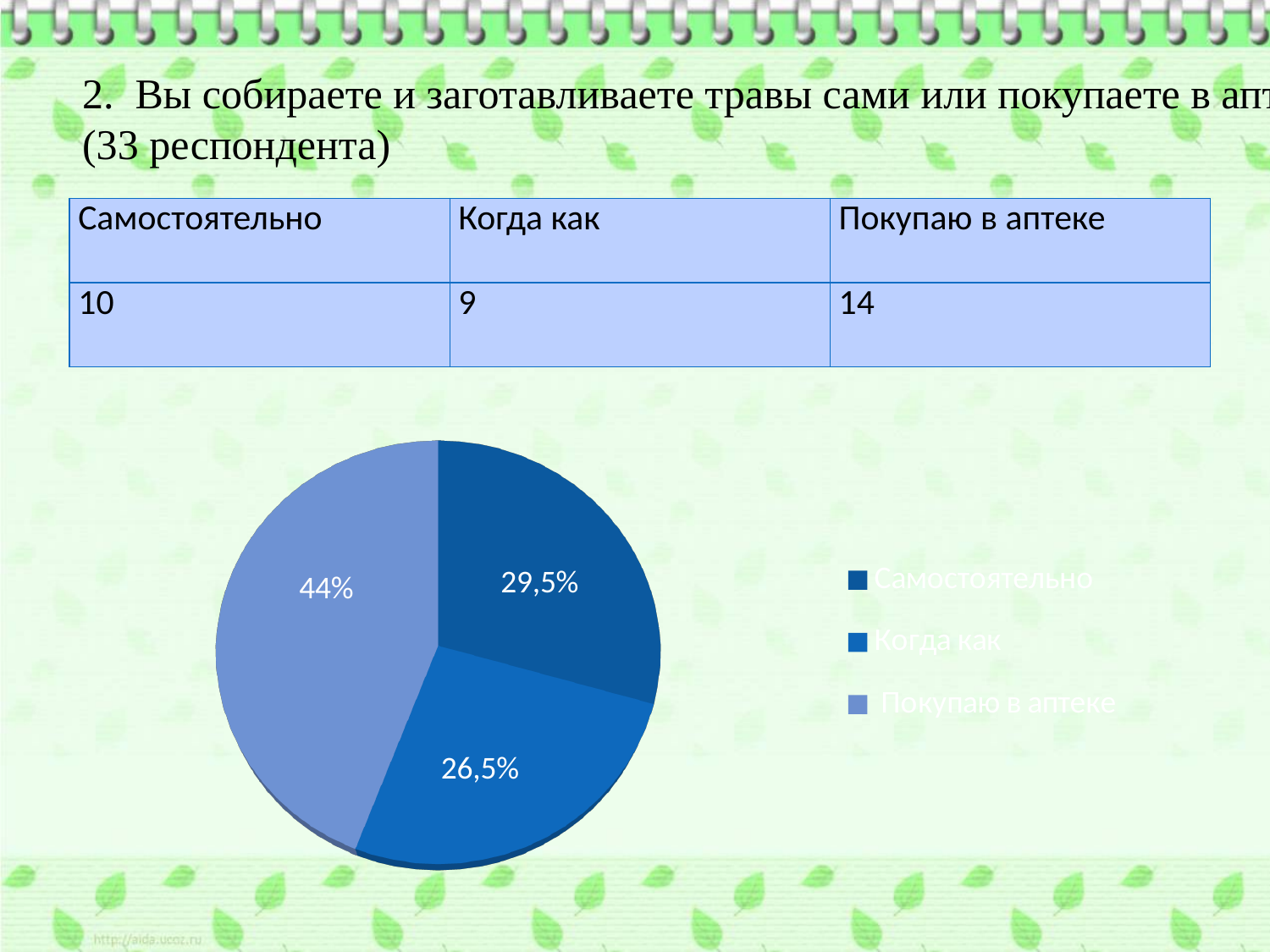
What kind of chart is shown on the slide? pie chart How many slices does the pie chart have? 3 Which legend entry of the pie chart is listed first? Самостоятельно Which slice is larger in the pie chart: "Самостоятельно" or "Когда как"? Самостоятельно What is the difference in percentage points between the "Покупаю в аптеке" slice and the "Самостоятельно" slice? 14,5% Which slice of the pie chart is the smallest? Когда как Which slice of the pie chart is the largest? Покупаю в аптеке How many entries does the legend of the pie chart list? 3 What percentage is shown for the "Самостоятельно" slice of the pie chart? 29,5% What percentage is shown for the "Когда как" slice of the pie chart? 26,5% Which legend entry of the pie chart is shown in the lightest blue colour? Покупаю в аптеке What percentage is shown for the "Покупаю в аптеке" slice of the pie chart? 44%